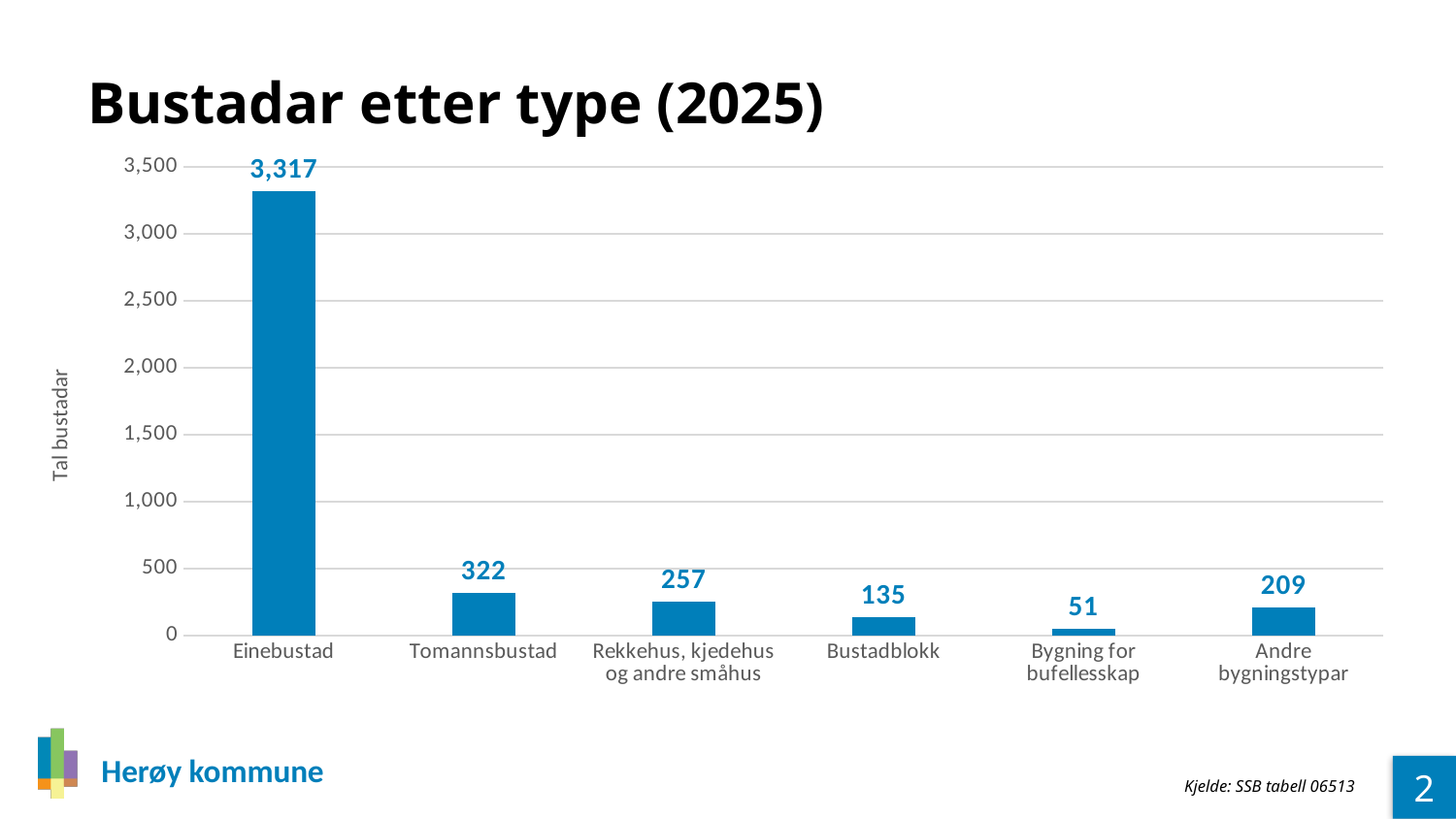
What is the difference between the values for Tomannsbustad and Rekkehus, kjedehus og andre småhus? 65 Which category has the lowest value? Bygning for bufellesskap How many categories are shown on the x axis? 6 What kind of chart is shown on the slide? bar chart Which category has the highest value? Einebustad What is the value for Tomannsbustad? 322 What is the value for Einebustad? 3,317 What is the title of the chart? Bustadar etter type (2025) Is the value for Einebustad greater or less than 3,000? greater What is the value for Bygning for bufellesskap? 51 Which is larger, the value for Andre bygningstypar or the value for Bustadblokk? Andre bygningstypar What is the value for Bustadblokk? 135